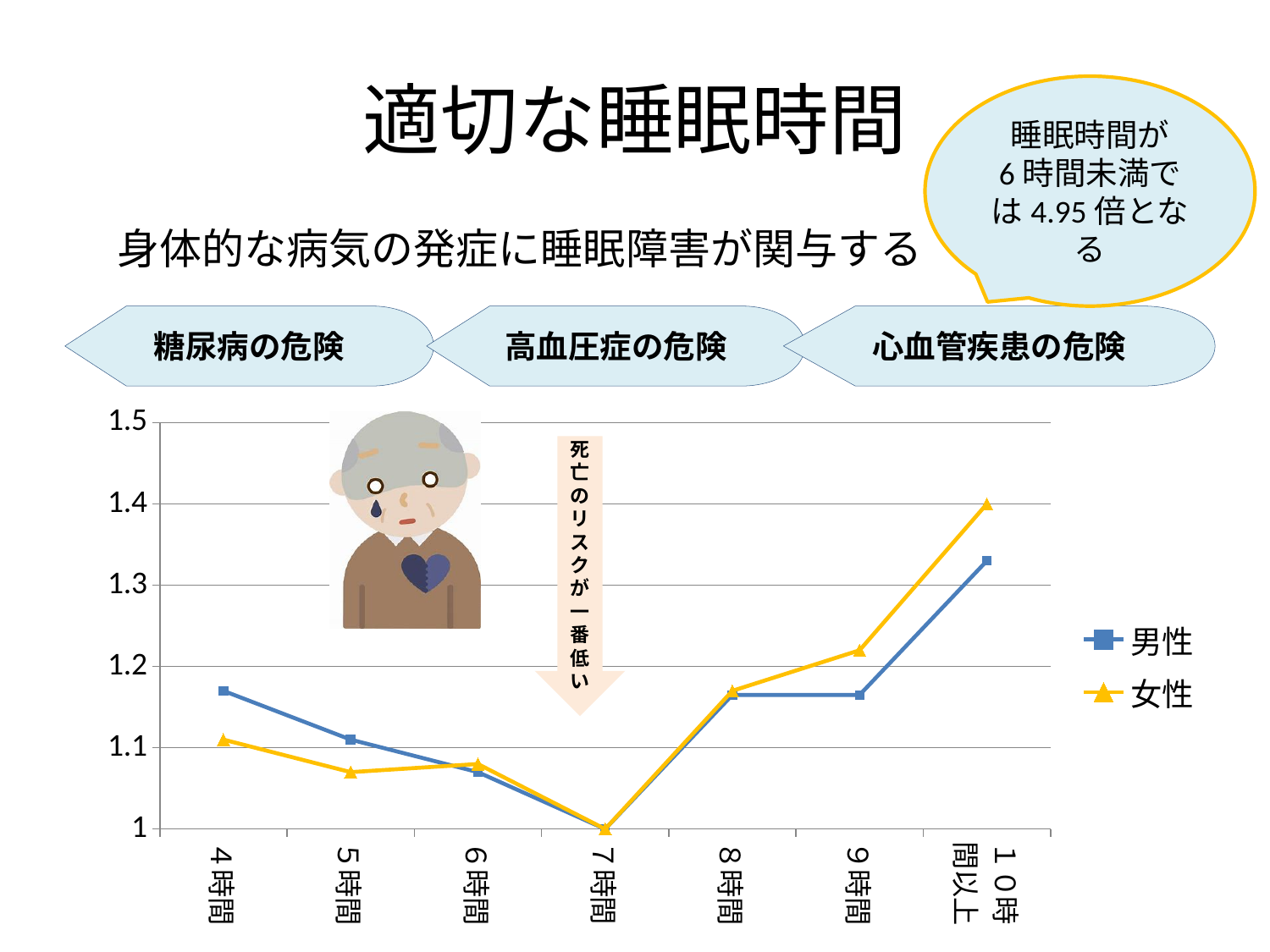
How many sleep-duration categories are shown on the x axis of the chart? 7 What kind of chart is shown on the slide? line chart Is the value for 男性 at 10時間以上 greater or less than 1.3? greater What is the value for 男性 at 7時間? 1 What is the value for 女性 at 7時間? 1 At 10時間以上, which series has the larger value, 男性 or 女性? 女性 At which sleep duration is the 女性 series highest? 10時間以上 How many series does the chart legend list? 2 At which sleep duration is the 男性 series lowest? 7時間 Does the 男性 series rise or fall from 7時間 to 10時間以上? rise At 4時間, which series has the larger value, 男性 or 女性? 男性 Is the value for 女性 at 4時間 greater or less than 1.2? less